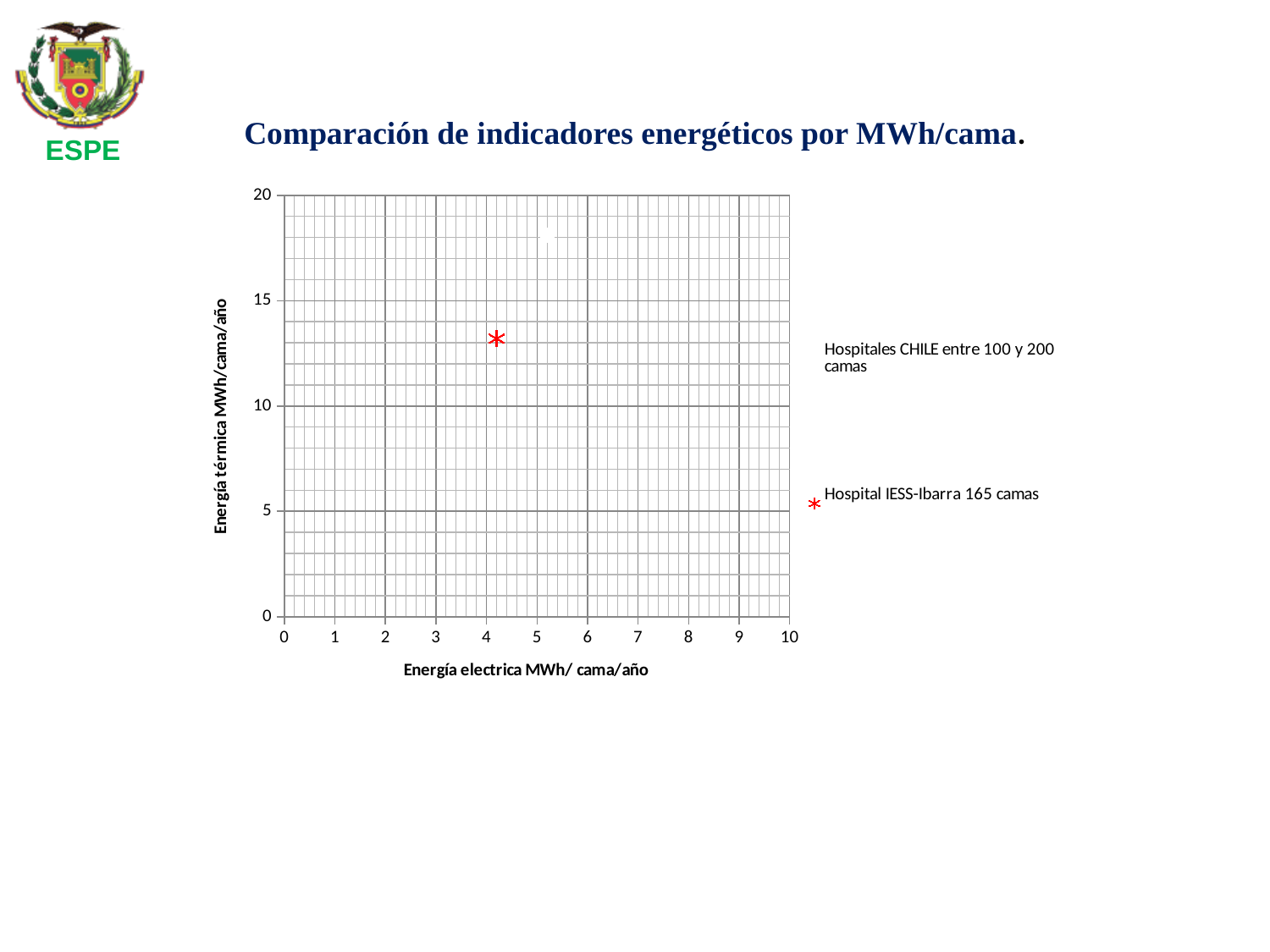
What is the title of the chart? Comparación de indicadores energéticos por MWh/cama. Is the thermal energy value (y axis) for Hospital IESS-Ibarra 165 camas greater or less than 15? less What is the label of the y axis? Energía térmica MWh/cama/año What is the maximum value shown on the x axis? 10 Is the electric energy value (x axis) for Hospital IESS-Ibarra 165 camas greater or less than 5? less Is the thermal energy value (y axis) for Hospital IESS-Ibarra 165 camas greater or less than 10? greater What kind of chart is shown on the slide? scatter chart How many series does the chart legend list? 2